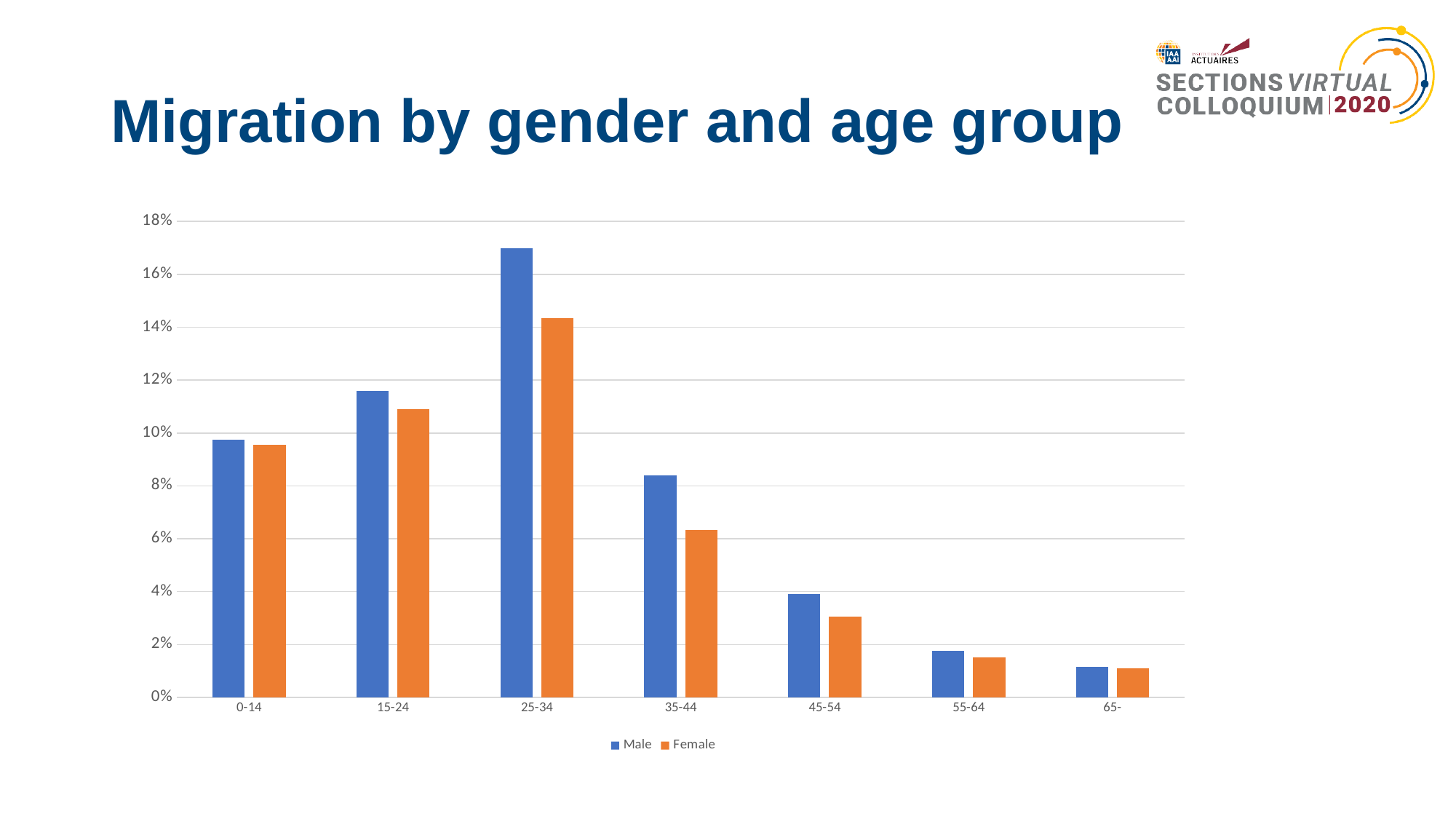
Is the Female value for 35-44 greater or less than 8%? less How many age groups are shown on the x axis? 7 For the 35-44 age group, which is larger, Male or Female? Male How many series does the legend list? 2 Which age group has the lowest Male value? 65- What kind of chart is shown on the slide? bar chart Do the Male values rise or fall from the 25-34 age group to the 65- age group? fall For the 25-34 age group, which is larger, Male or Female? Male Which age group has the highest Female value? 25-34 Which age group has the highest Male value? 25-34 What is the title of the chart on the slide? Migration by gender and age group Is the Male value for 25-34 greater or less than 16%? greater